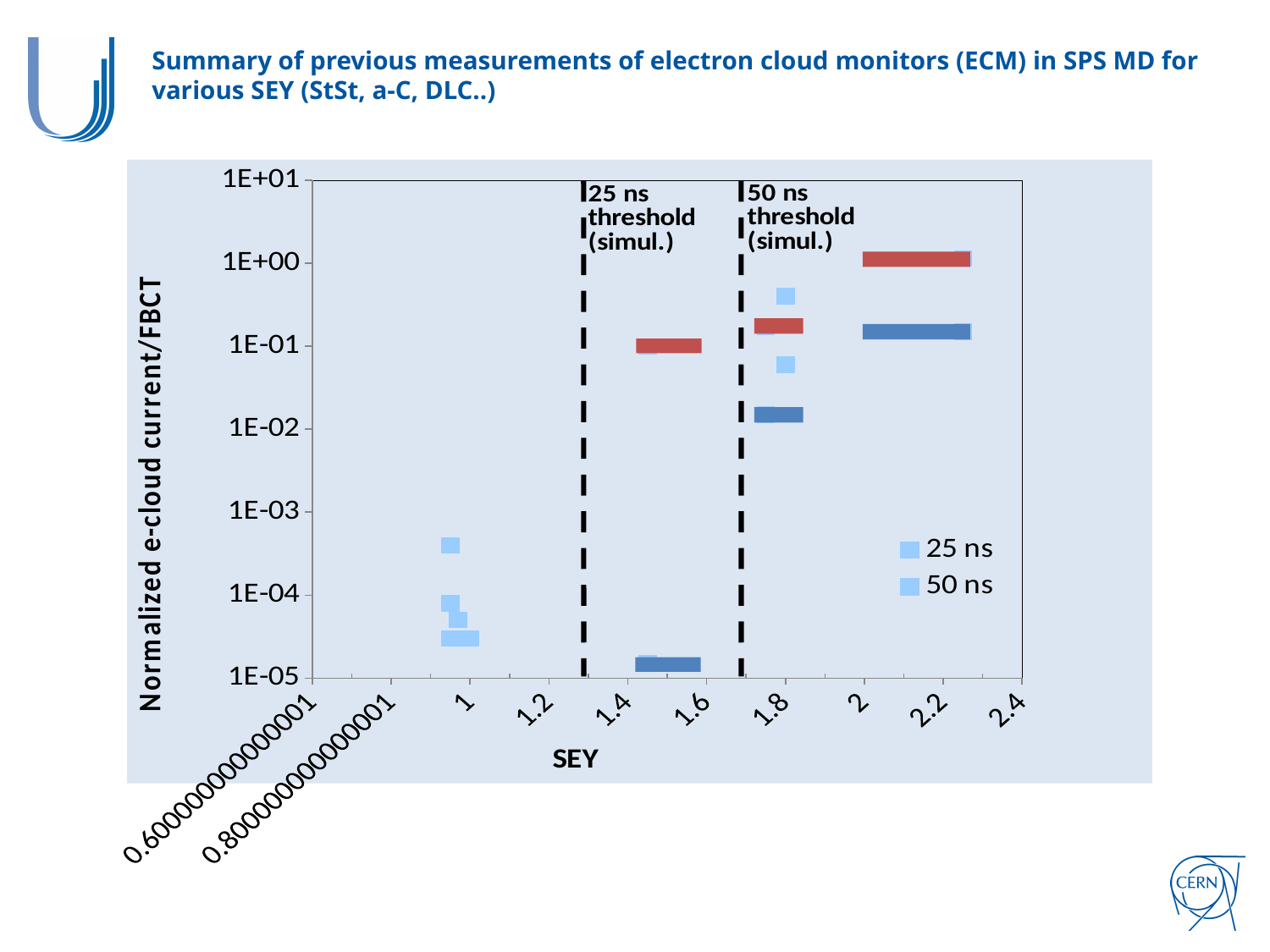
Is the value of the red band plotted between SEY 2 and 2.2 greater or less than 1E-01? greater What kind of chart is shown on the slide? scatter chart Is the value of the red band plotted near SEY 1.5 greater or less than 1E-02? greater Is the value of the dark blue band plotted near SEY 1.8 greater or less than 1E-01? less Which red band is plotted higher: the one near SEY 1.5 or the one between SEY 2 and 2.2? the one between SEY 2 and 2.2 How many series does the chart legend list? 2 Between SEY 2 and 2.2, which band is plotted higher, the red one or the dark blue one? the red one What are the two entries in the chart legend? 25 ns and 50 ns Do the plotted values generally rise or fall as SEY increases along the x axis? rise Which dark blue band is plotted higher: the one near SEY 1.5 or the one near SEY 1.8? the one near SEY 1.8 What do the two dashed vertical lines on the chart mark? 25 ns threshold (simul.) and 50 ns threshold (simul.)